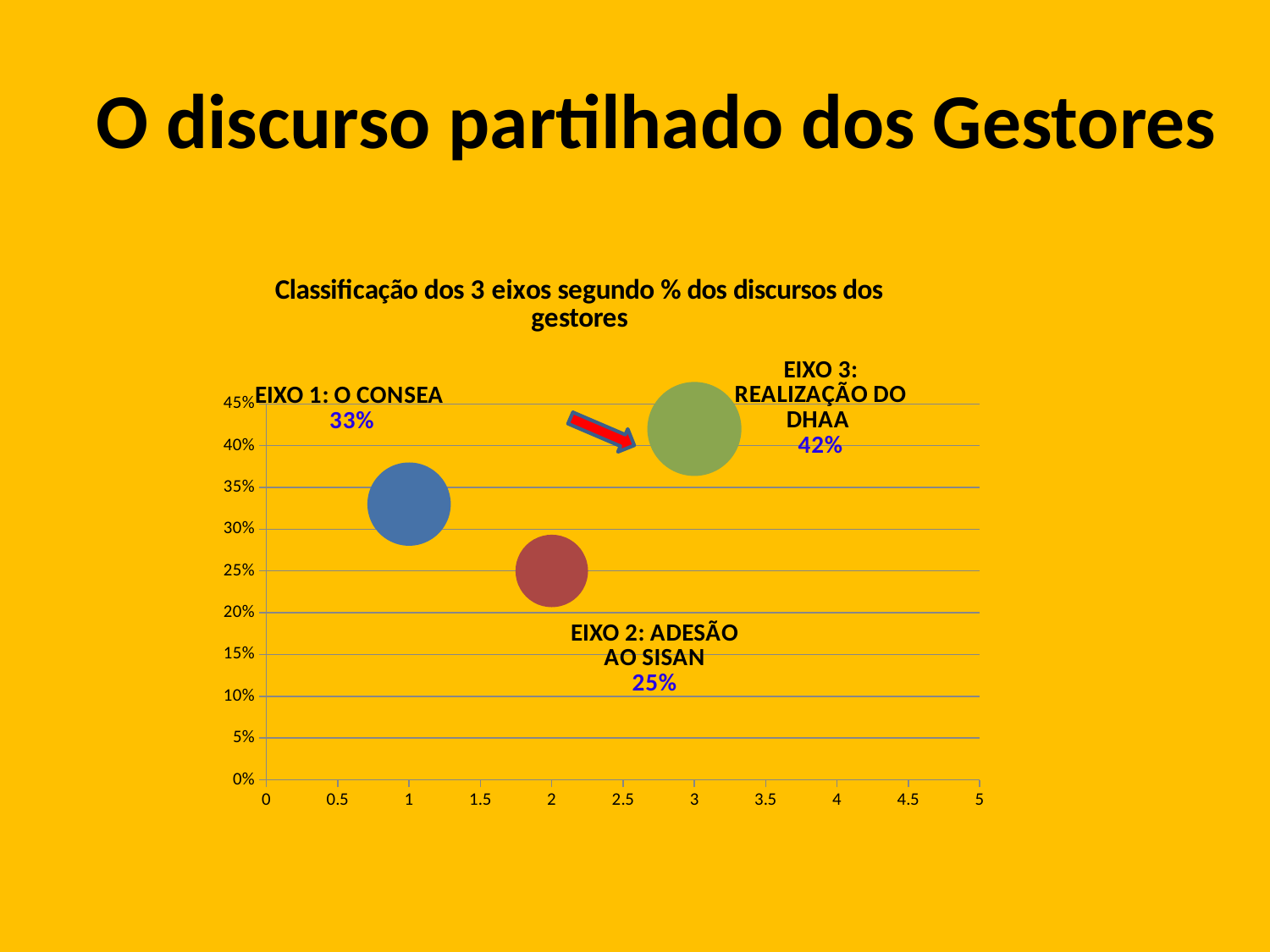
Is the value for EIXO 3: REALIZAÇÃO DO DHAA greater or less than 40%? greater What kind of chart is shown on the slide? Bubble chart What is the value shown for EIXO 1: O CONSEA? 33% Which is larger, the value for EIXO 1: O CONSEA or the value for EIXO 3: REALIZAÇÃO DO DHAA? EIXO 3: REALIZAÇÃO DO DHAA What is the difference between the values for EIXO 1: O CONSEA and EIXO 2: ADESÃO AO SISAN? 8% How many eixos (bubbles) are plotted on the chart? 3 What is the difference between the values for EIXO 3: REALIZAÇÃO DO DHAA and EIXO 2: ADESÃO AO SISAN? 17% What is the value shown for EIXO 3: REALIZAÇÃO DO DHAA? 42% What is the value shown for EIXO 2: ADESÃO AO SISAN? 25% What is the title of the chart? Classificação dos 3 eixos segundo % dos discursos dos gestores Which eixo has the highest percentage? EIXO 3: REALIZAÇÃO DO DHAA Which eixo has the lowest percentage? EIXO 2: ADESÃO AO SISAN